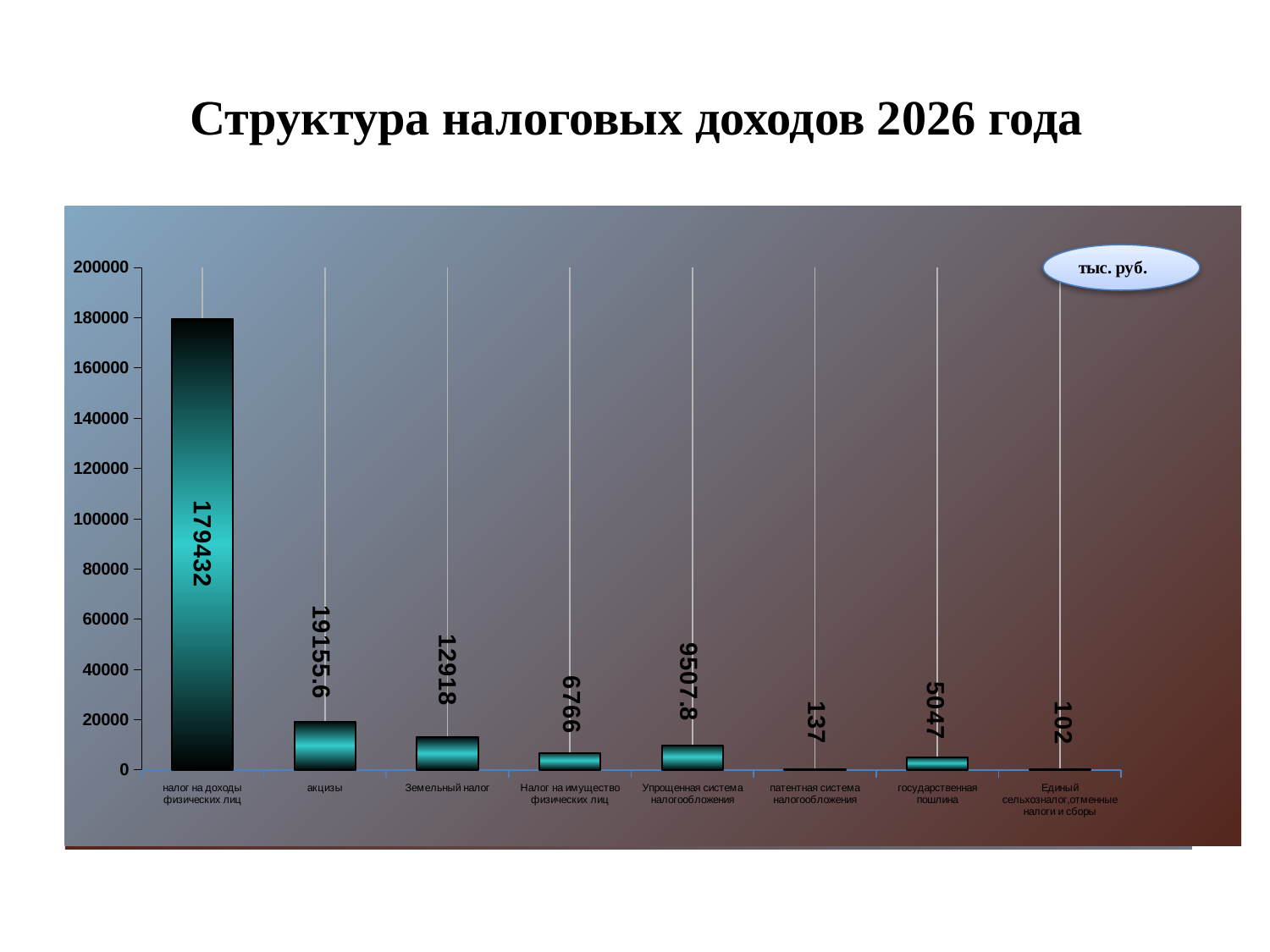
Which category has the highest value? налог на доходы физических лиц What is the value for государственная пошлина? 5047 Is the value for налог на доходы физических лиц greater or less than 160000? greater What is the value for Упрощенная система налогообложения? 9507.8 What unit is indicated in the label at the top right of the chart? тыс. руб. What kind of chart is shown on the slide? bar chart What is the value for налог на доходы физических лиц? 179432 What is the difference between the values for Земельный налог and Налог на имущество физических лиц? 6152 How many categories are shown in the chart? 8 Which category has the lowest value? Единый сельхозналог,отменные налоги и сборы What is the value for акцизы? 19155.6 Which is larger, the value for акцизы or the value for Земельный налог? акцизы